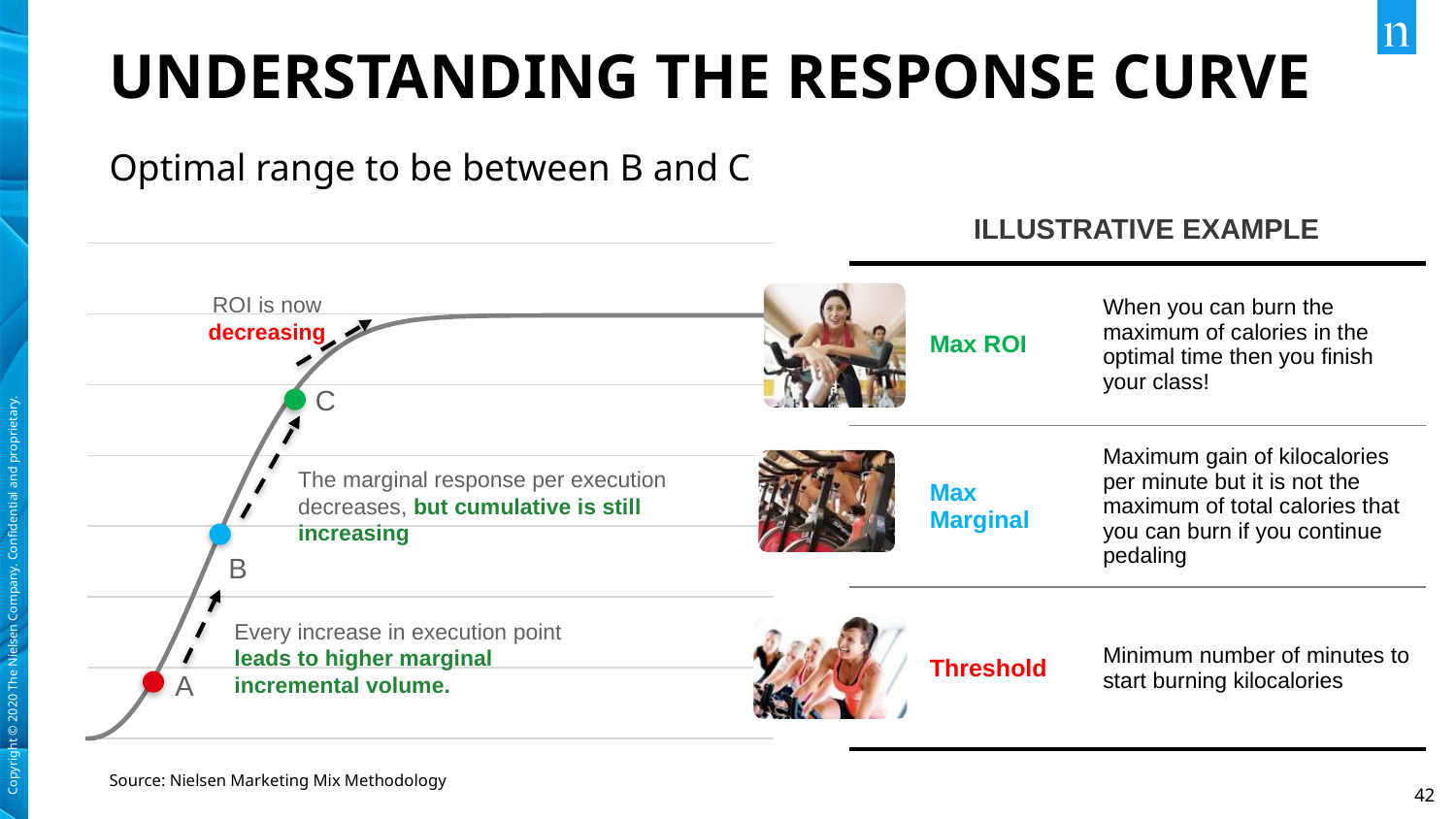
What colour is the marker for point A on the curve? red According to the slide, between which two points is the optimal range? B and C Which labeled point on the curve is the lowest? A What kind of chart is shown on the left of the slide? line chart How many labeled points are marked on the response curve? 3 What are the labels of the points marked on the response curve? A, B and C Which point on the curve is higher, B or C? C Which point on the curve is higher, A or B? B Which labeled point on the curve is the highest? C Does the response curve rise or fall as it moves from left to right? rise